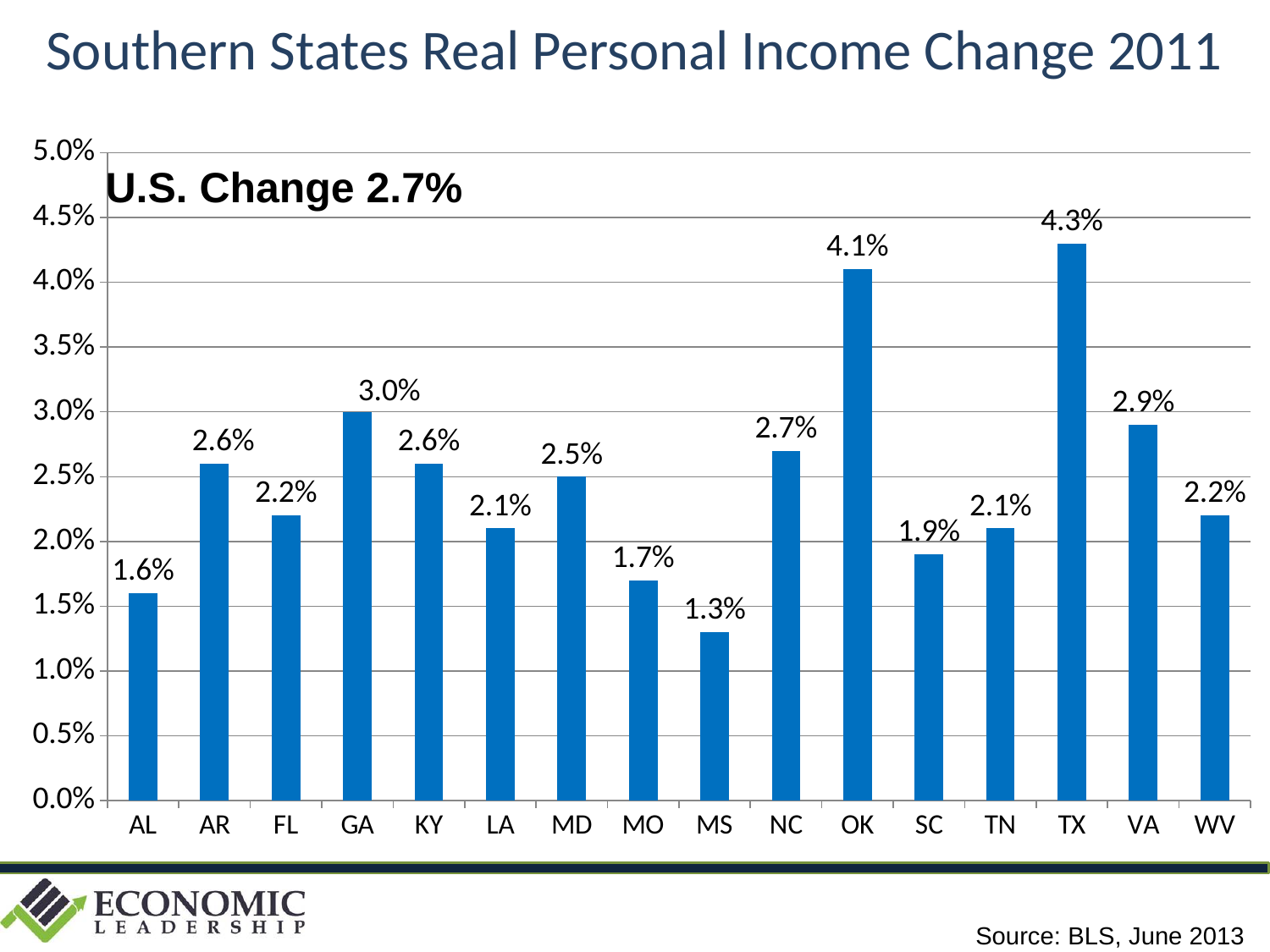
Which state has the highest real personal income change? TX Which state has the lowest real personal income change? MS What is the real personal income change for MS? 1.3% What kind of chart is shown on the slide? bar chart What is the real personal income change for TX? 4.3% What is the difference between the values for OK and SC? 2.2% Which has a larger real personal income change, GA or VA? GA What is the source cited on the slide? BLS, June 2013 What is the real personal income change for NC? 2.7% What is the U.S. change noted on the chart? 2.7% How many states are shown on the chart? 16 Is the value for AL greater or less than 2.0%? less